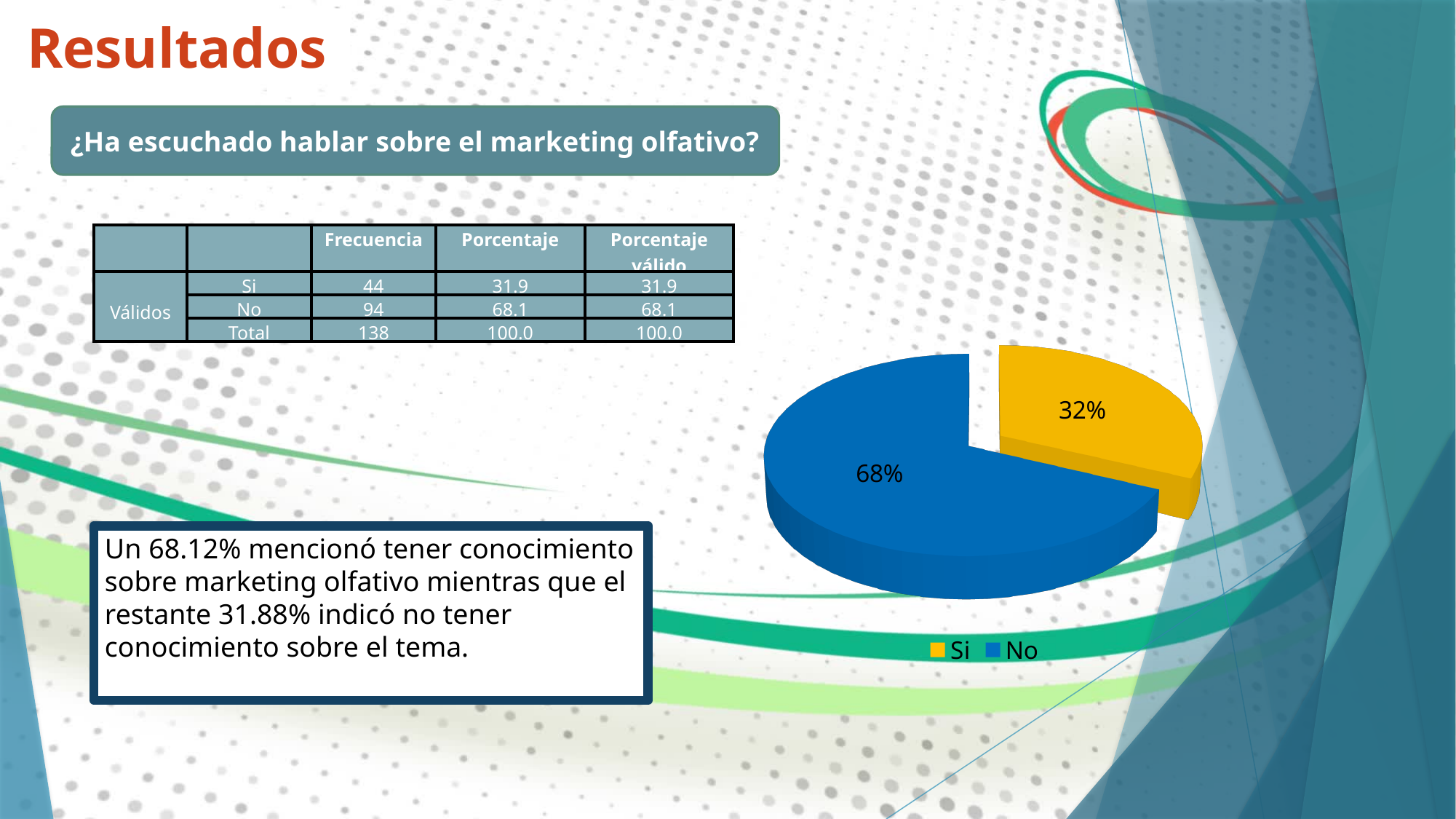
Which slice of the pie chart is the largest? No Which slice of the pie chart is the smallest? Si What kind of chart is shown on the slide? pie chart How many slices does the pie chart have? 2 What colour is the 'No' slice in the pie chart? blue What percentage does the 'Si' slice show in the pie chart? 32% What colour is the 'Si' slice in the pie chart? yellow Which is larger in the pie chart, the 'Si' slice or the 'No' slice? No How many entries does the legend of the pie chart list? 2 What percentage does the 'No' slice show in the pie chart? 68% What is the difference in percentage points between the 'No' slice and the 'Si' slice in the pie chart? 36